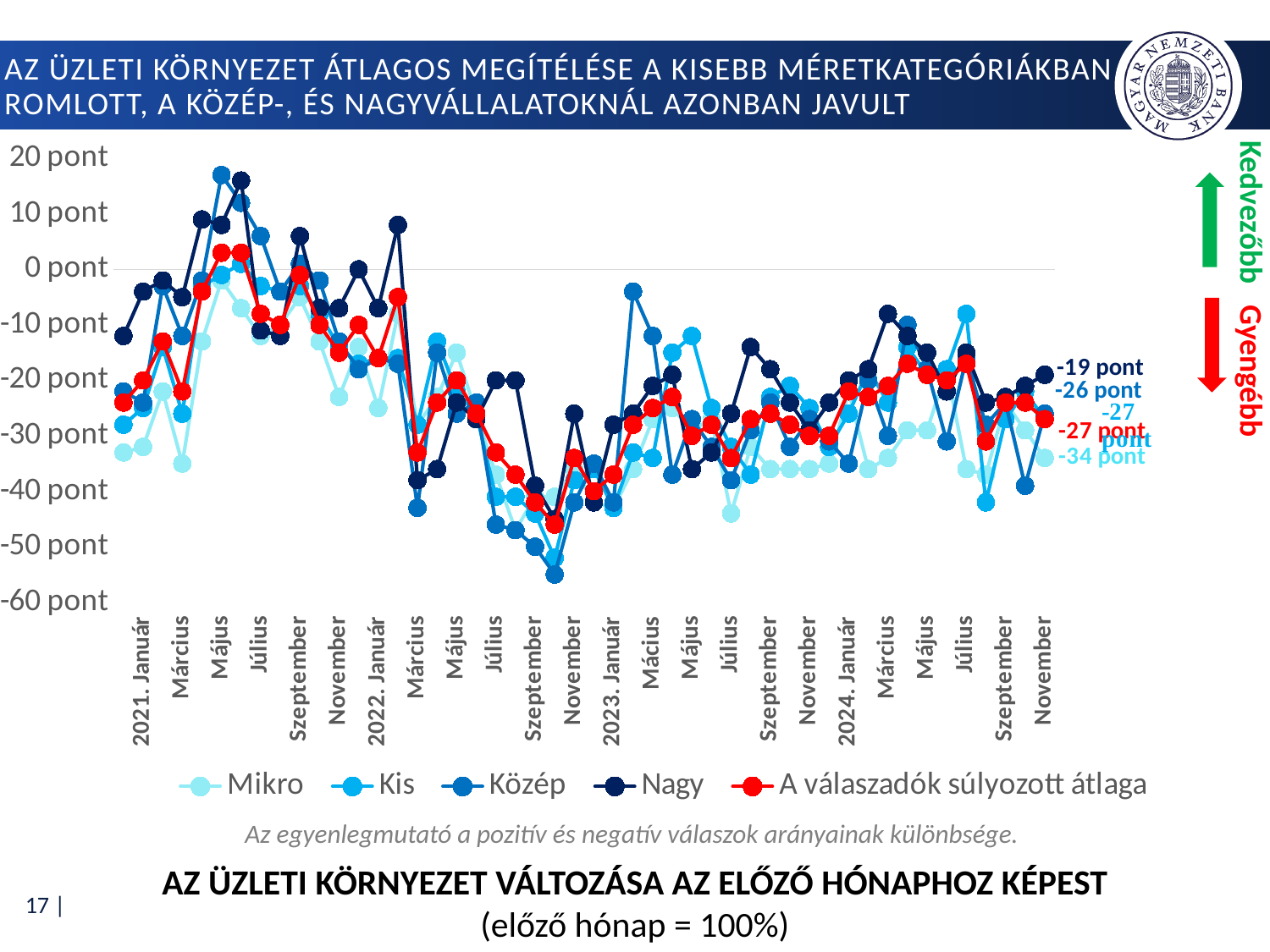
At the end of the chart, which is larger: the Nagy value or the Közép value? Nagy Is the value for Közép in Május 2021 greater or less than 10 pont? greater What is the difference between the final values of Nagy (-19 pont) and Mikro (-34 pont)? 15 pont How many series does the legend list? 5 What is the final labelled value for 'A válaszadók súlyozott átlaga'? -27 pont Which series has the lowest value at the end of the chart (November 2024)? Mikro What is the final labelled value for the Nagy series? -19 pont Which series has the highest value at the end of the chart (November 2024)? Nagy What is the final labelled value for the Közép series? -26 pont What is the final labelled value for the Mikro series? -34 pont Which series is drawn in red in the legend? A válaszadók súlyozott átlaga What kind of chart is shown on the slide? line chart